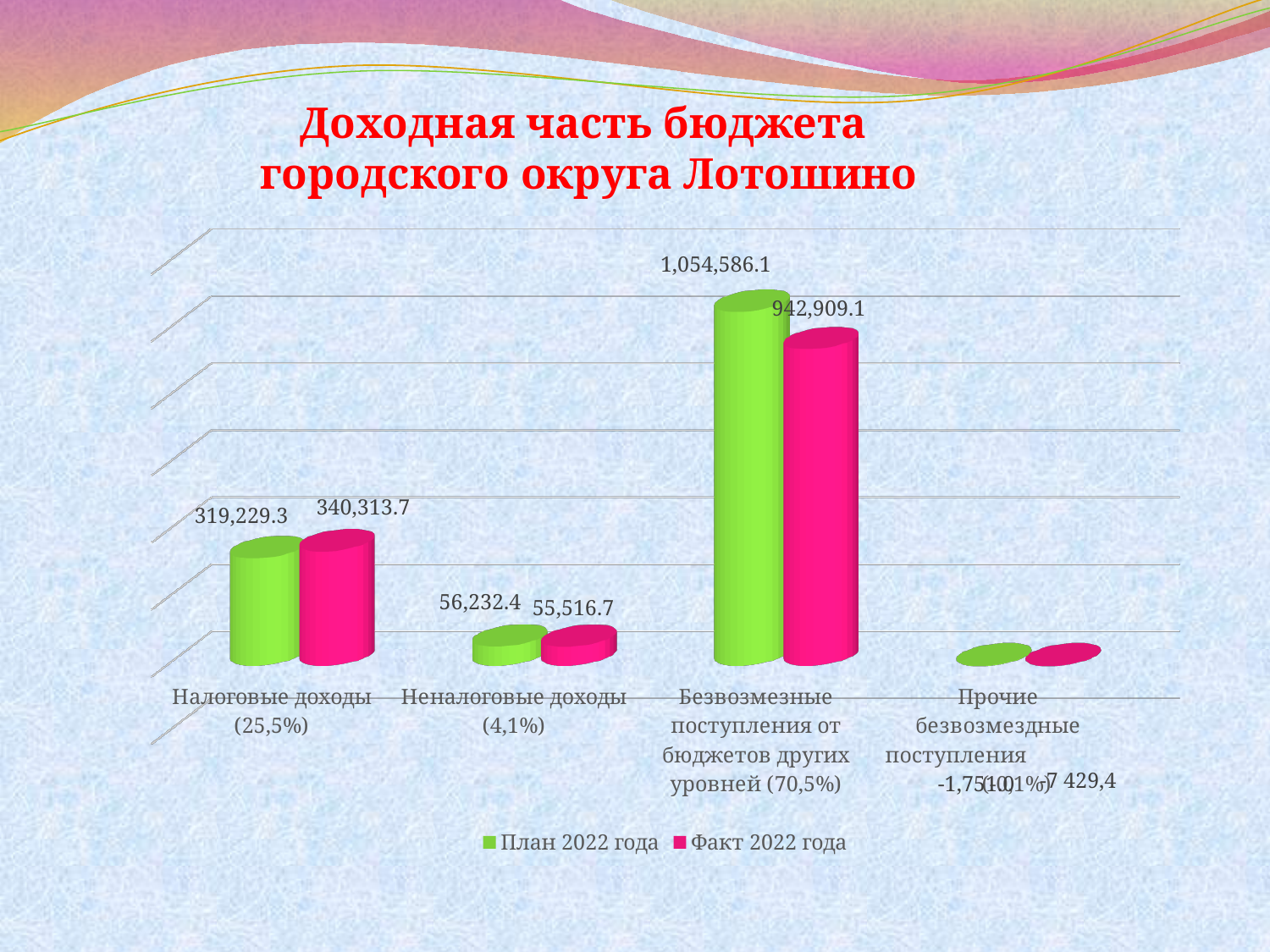
Which category has the highest value for План 2022 года? Безвозмезные поступления от бюджетов других уровней (70,5%) What is the value of План 2022 года for Налоговые доходы (25,5%)? 319,229.3 Which is larger for Безвозмезные поступления от бюджетов других уровней (70,5%): План 2022 года or Факт 2022 года? План 2022 года How many categories are shown on the x axis? 4 What is the title of the chart? Доходная часть бюджета городского округа Лотошино What is the value of Факт 2022 года for Неналоговые доходы (4,1%)? 55,516.7 What is the difference between Факт 2022 года and План 2022 года for Налоговые доходы (25,5%)? 21,084.4 How many series does the legend list? 2 What is the value of План 2022 года for Безвозмезные поступления от бюджетов других уровней (70,5%)? 1,054,586.1 What is the value of Факт 2022 года for Налоговые доходы (25,5%)? 340,313.7 What is the difference between План 2022 года and Факт 2022 года for Безвозмезные поступления от бюджетов других уровней (70,5%)? 111,677.0 What type of chart is shown on the slide? Bar chart